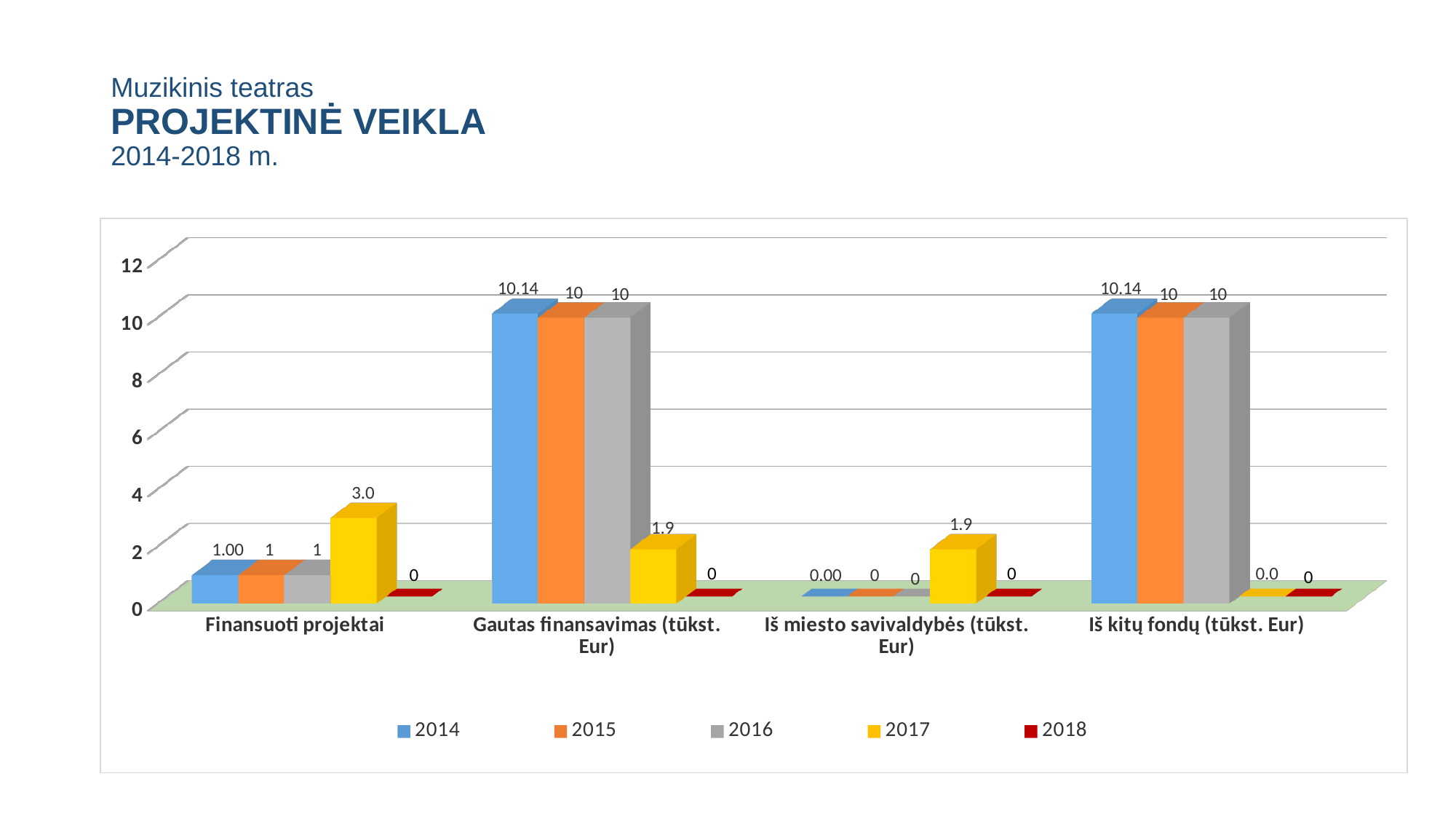
What is the value for 2016 in the Iš kitų fondų (tūkst. Eur) category? 10 Which is larger in the Finansuoti projektai category: the value for 2017 or the value for 2014? 2017 Which year has the highest value in the Gautas finansavimas (tūkst. Eur) category? 2014 Is the value for 2014 in the Iš kitų fondų (tūkst. Eur) category greater or less than 8? greater How many categories are shown on the x axis? 4 What is the difference between the 2014 and 2017 values in the Gautas finansavimas (tūkst. Eur) category? 8.24 What kind of chart is shown on the slide? bar chart What is the value for 2017 in the Iš miesto savivaldybės (tūkst. Eur) category? 1.9 How many series does the legend list? 5 What is the value for 2014 in the Gautas finansavimas (tūkst. Eur) category? 10.14 What is the value for 2017 in the Finansuoti projektai category? 3.0 Which year has the highest value in the Finansuoti projektai category? 2017